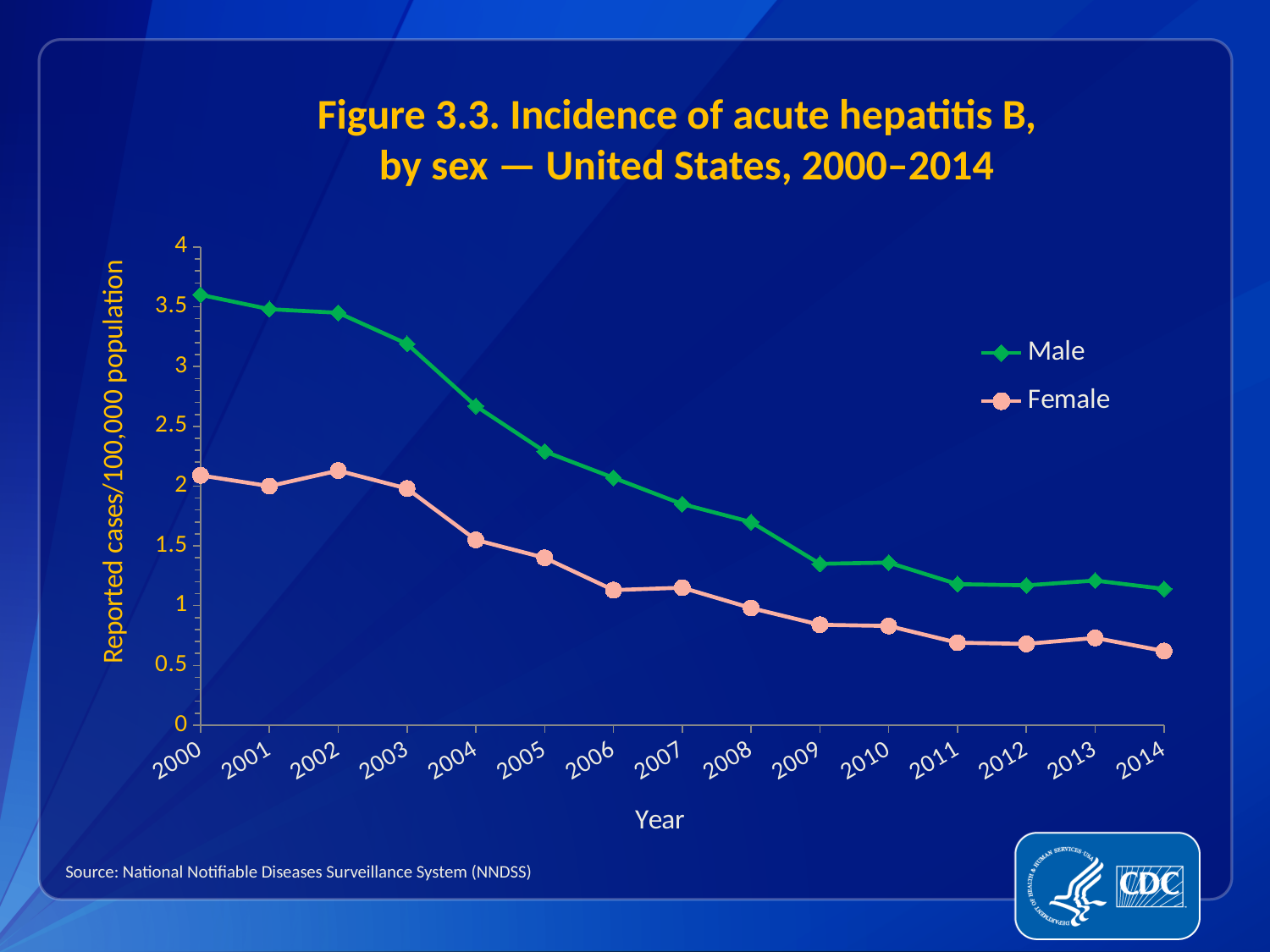
What is the label on the y axis? Reported cases/100,000 population Is the Female value for 2014 greater or less than 1? less How many series does the legend list? 2 What kind of chart is shown on the slide? line chart Does the Male incidence rate rise or fall from 2000 to 2014? fall Is the Female value for 2004 greater or less than 2? less In 2005, which series has the higher value, Male or Female? Male Is the Male value for 2000 greater or less than 3? greater How many years are plotted along the x axis? 15 In which year is the Male incidence rate highest? 2000